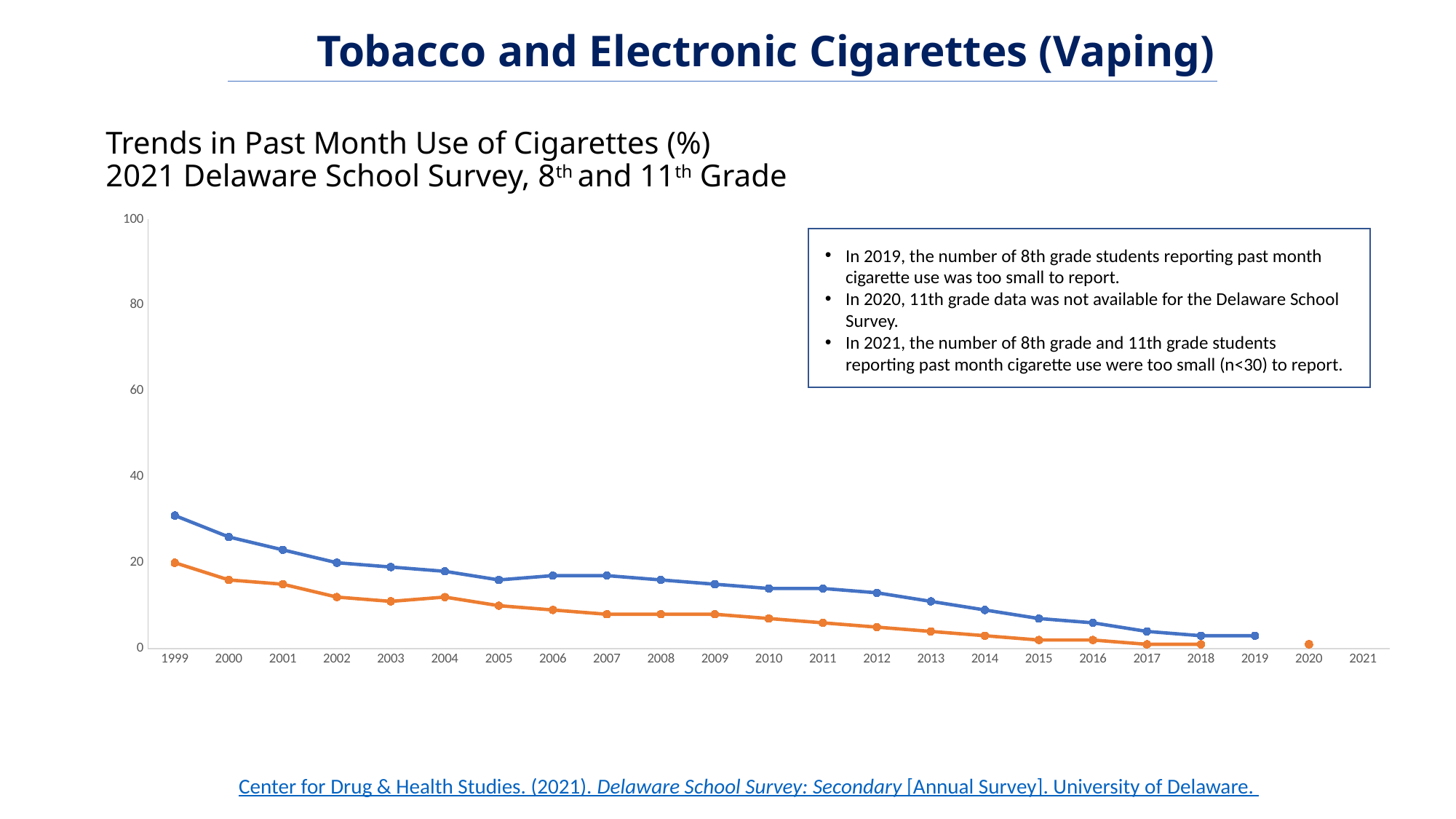
What kind of chart is shown on the slide? line chart Is the value of the blue line in 2005 greater or less than 20? less What is the first year shown on the x axis? 1999 How many year labels appear on the x axis of the chart? 23 Is the value of the blue line in 2018 greater or less than 20? less How many lines are plotted on the chart? 2 Is the value of the blue line in 1999 greater or less than 20? greater Do the values of the blue line generally rise or fall from 1999 to 2019? fall What is the highest value shown on the y axis? 100 In 2010, which line has the higher value, the blue line or the orange line? the blue line In which year does the orange line reach its highest value? 1999